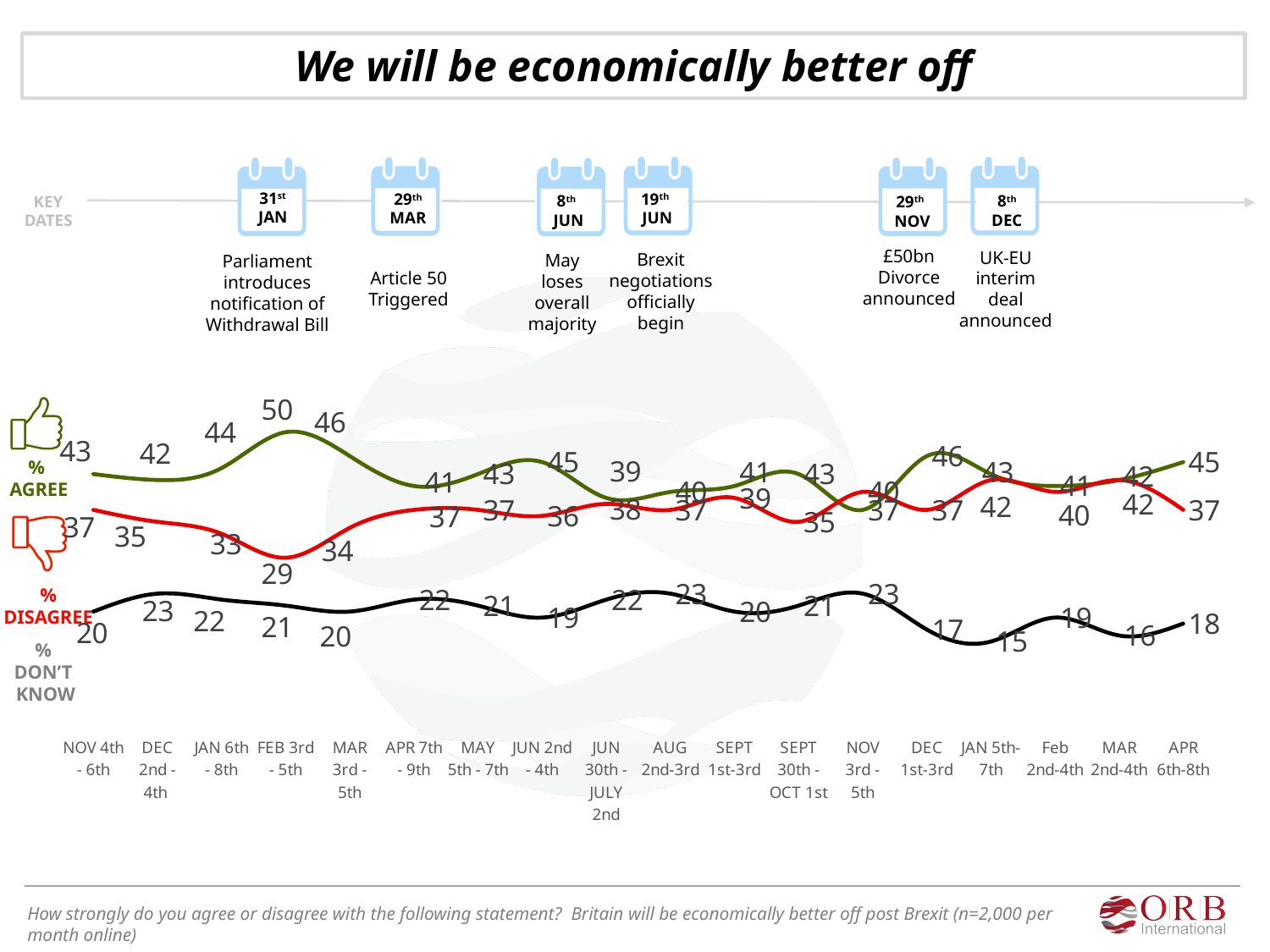
What type of chart is shown on the slide? line chart At which survey date is % DON'T KNOW at its lowest? JAN 5th-7th Does % DISAGREE rise or fall from NOV 4th - 6th to FEB 3rd - 5th? fall What is the % DISAGREE value for NOV 4th - 6th? 37 What is the % AGREE value for FEB 3rd - 5th? 50 At NOV 3rd - 5th, which is larger: % AGREE or % DISAGREE? % DISAGREE At which survey date does % AGREE reach its highest value? FEB 3rd - 5th How many series are plotted on the chart? 3 How many survey dates are plotted along the x axis? 18 What is the difference between % AGREE and % DISAGREE at FEB 3rd - 5th? 21 What is the title of the chart? We will be economically better off What is the % DON'T KNOW value for APR 6th-8th? 18